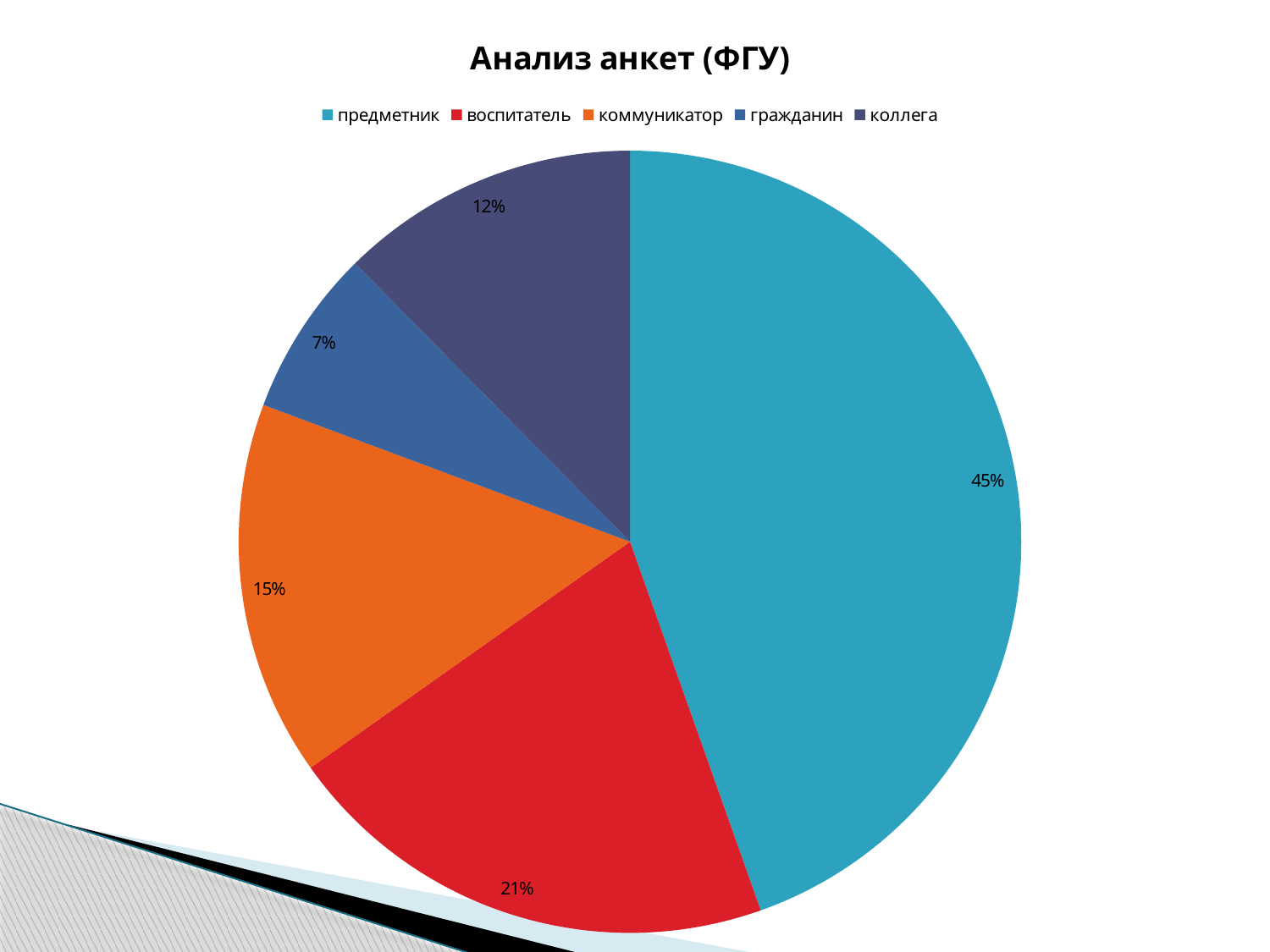
What is the value shown for воспитатель? 21% Which is larger, коммуникатор or коллега? коммуникатор What is the value shown for гражданин? 7% What is the title of the chart? Анализ анкет (ФГУ) What is the value shown for коллега? 12% How many slices does the pie chart have? 5 Which category has the smallest slice? гражданин What is the difference between the values for предметник and воспитатель? 24% Which category has the largest slice? предметник What is the value shown for коммуникатор? 15% What share of the pie does предметник have? 45% What kind of chart is shown on the slide? pie chart